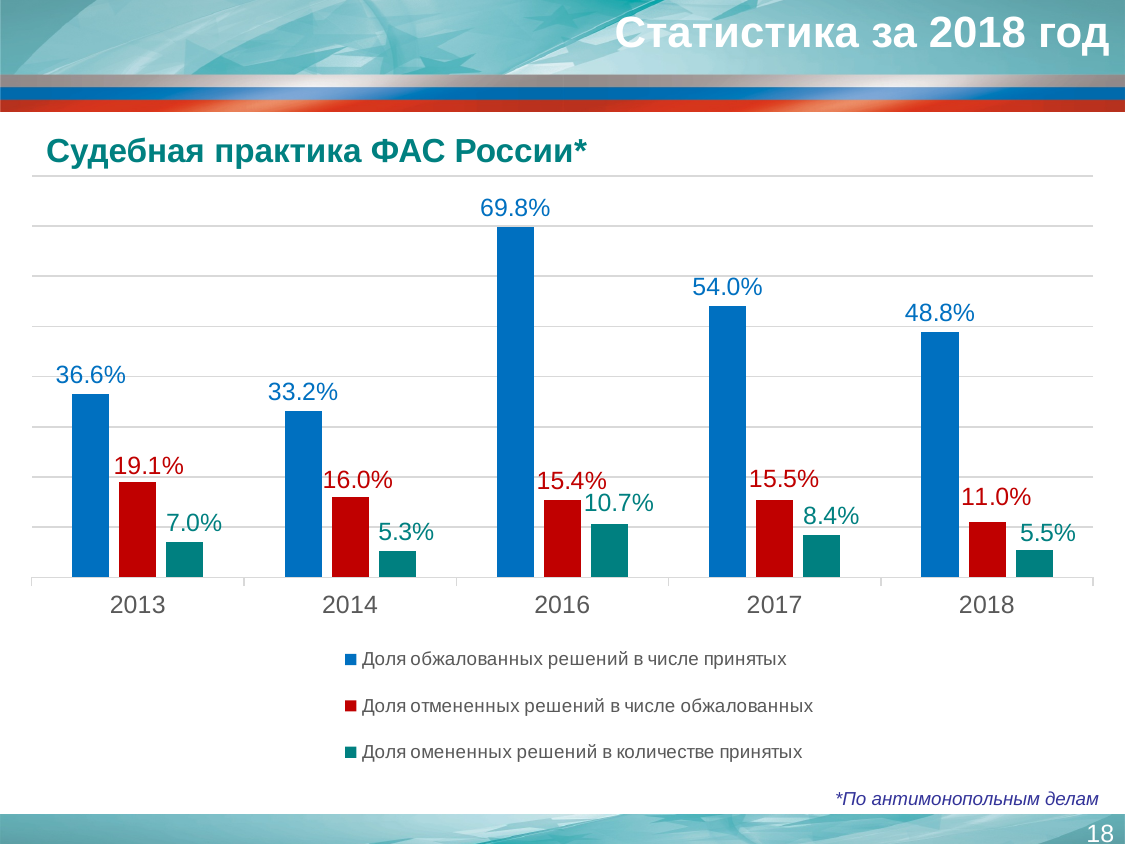
How many years are shown on the x axis? 5 What is the share of appealed decisions among adopted decisions (Доля обжалованных решений в числе принятых) in 2016? 69.8% What is the difference between the share of appealed decisions in 2017 and in 2018? 5.2% How many series does the legend list? 3 What is the share of overturned decisions among appealed decisions (Доля отмененных решений в числе обжалованных) in 2013? 19.1% In which year is the share of appealed decisions among adopted decisions the highest? 2016 What is the value of the teal series (Доля омененных решений в количестве принятых) for 2018? 5.5% In which year is the teal series (Доля омененных решений в количестве принятых) the lowest? 2014 Which is larger: the red series value for 2014 or for 2017? 2014 Does the share of appealed decisions among adopted decisions rise or fall from 2016 to 2018? Fall What is the title of the chart? Судебная практика ФАС России* What kind of chart is shown on the slide? Bar chart